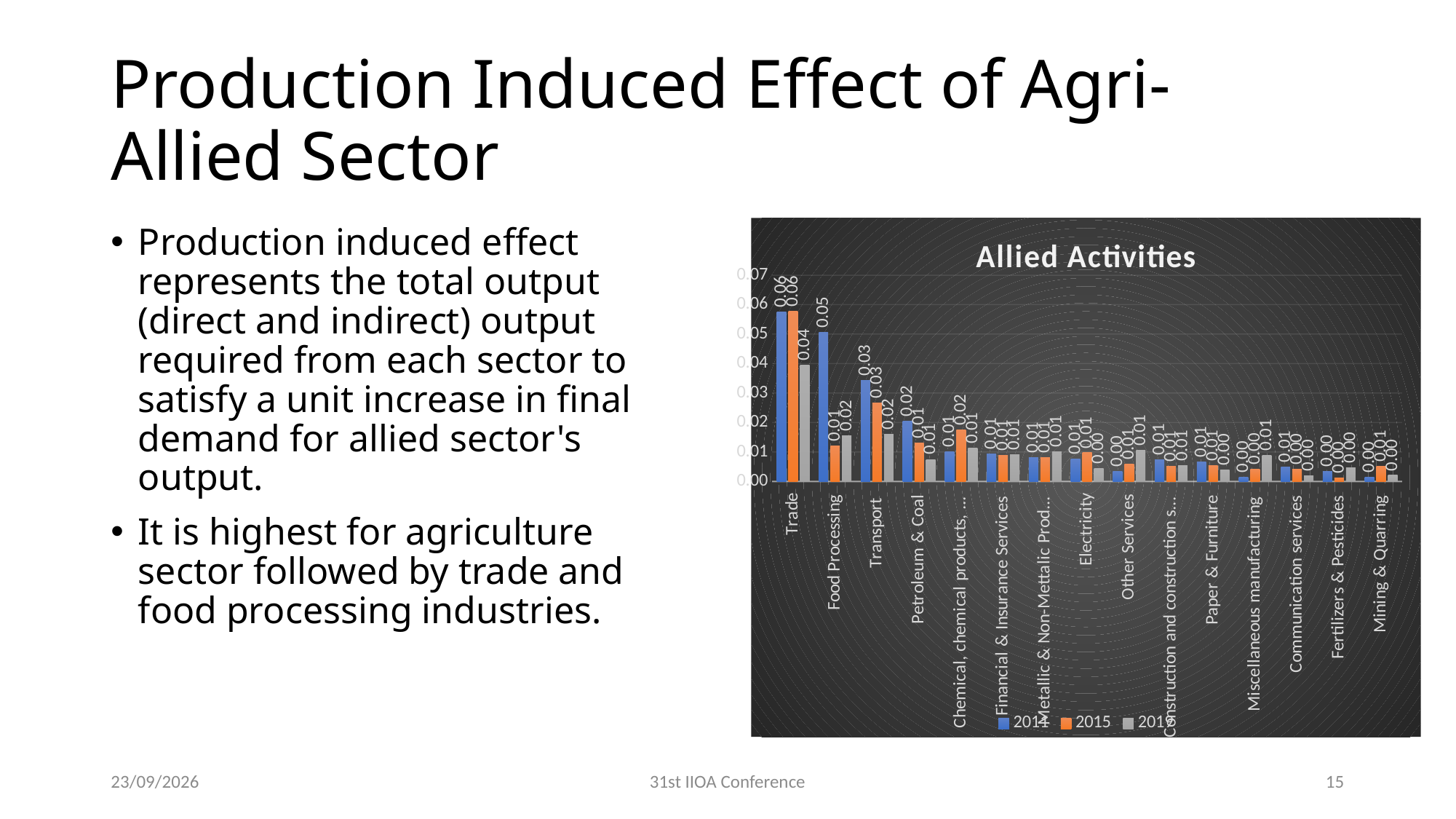
What is the 2014 value for Trade? 0.06 What is the title of the chart? Allied Activities Is the 2014 value for Trade greater or less than 0.05? greater Do the 2014 values generally rise or fall moving from left to right along the x axis? fall Which category has the highest 2014 value? Trade How many categories are plotted along the x axis of the chart? 15 Which has the larger 2014 value, Food Processing or Transport? Food Processing What is the 2014 value for Food Processing? 0.05 How many series does the chart's legend list? 3 What is the 2015 value for Transport? 0.03 What kind of chart is shown on the slide? bar chart